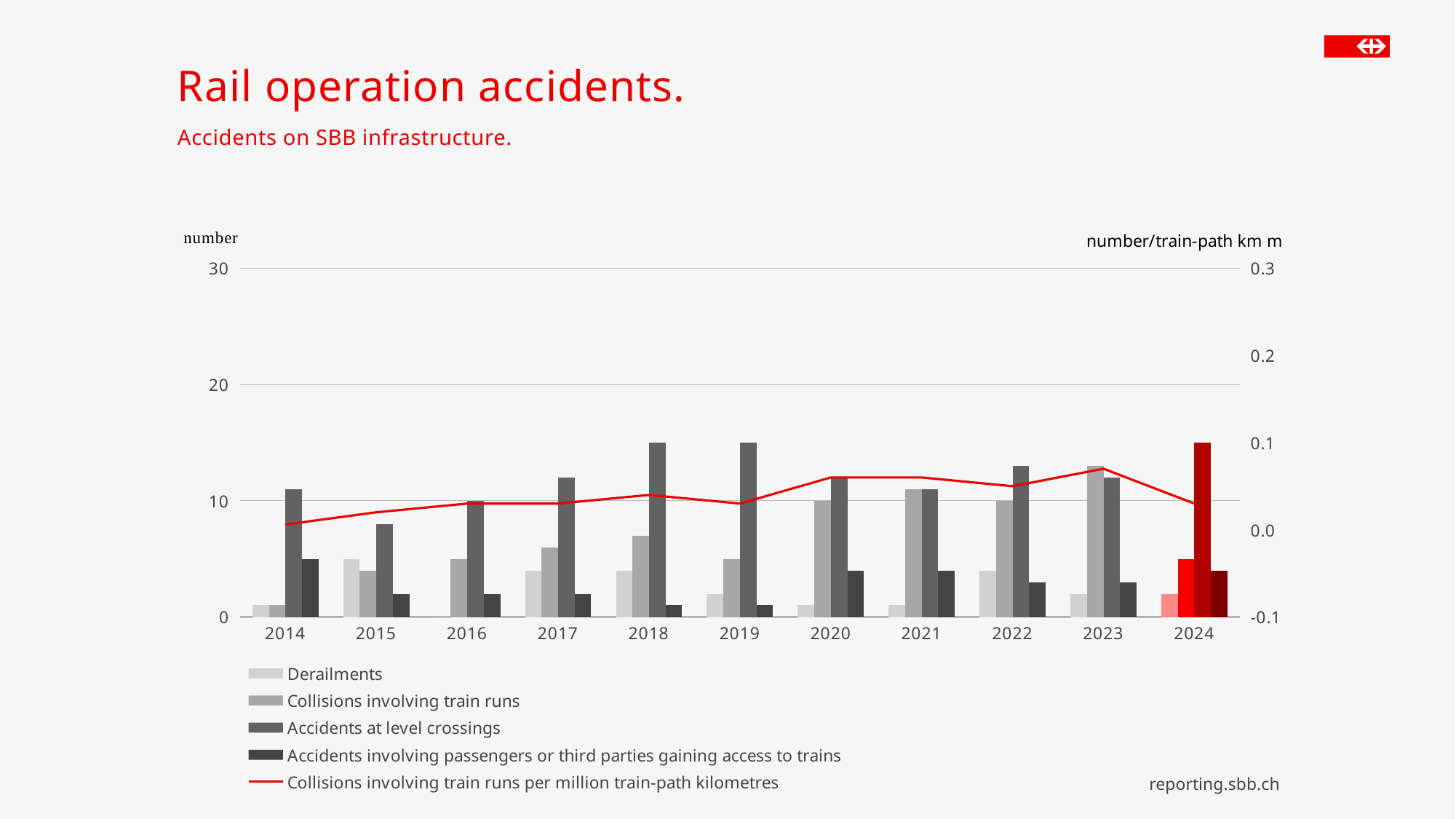
Is the value for Derailments in 2015 greater or less than 10? less Does the line for Collisions involving train runs per million train-path kilometres rise or fall from 2014 to 2020? rise Which year has the lowest value for Collisions involving train runs? 2014 Is the value for Collisions involving train runs per million train-path kilometres in 2020 greater or less than 0.0? greater Which year has the lowest value for Accidents at level crossings? 2015 How many years are shown on the x axis? 11 What is the label of the right-hand axis? number/train-path km m Which year has the highest value for Collisions involving train runs? 2023 How many series does the legend list? 5 What is the title of the chart on the slide? Rail operation accidents. Is the value for Accidents at level crossings in 2018 greater or less than 10? greater What kind of chart is shown? Bar chart with a line